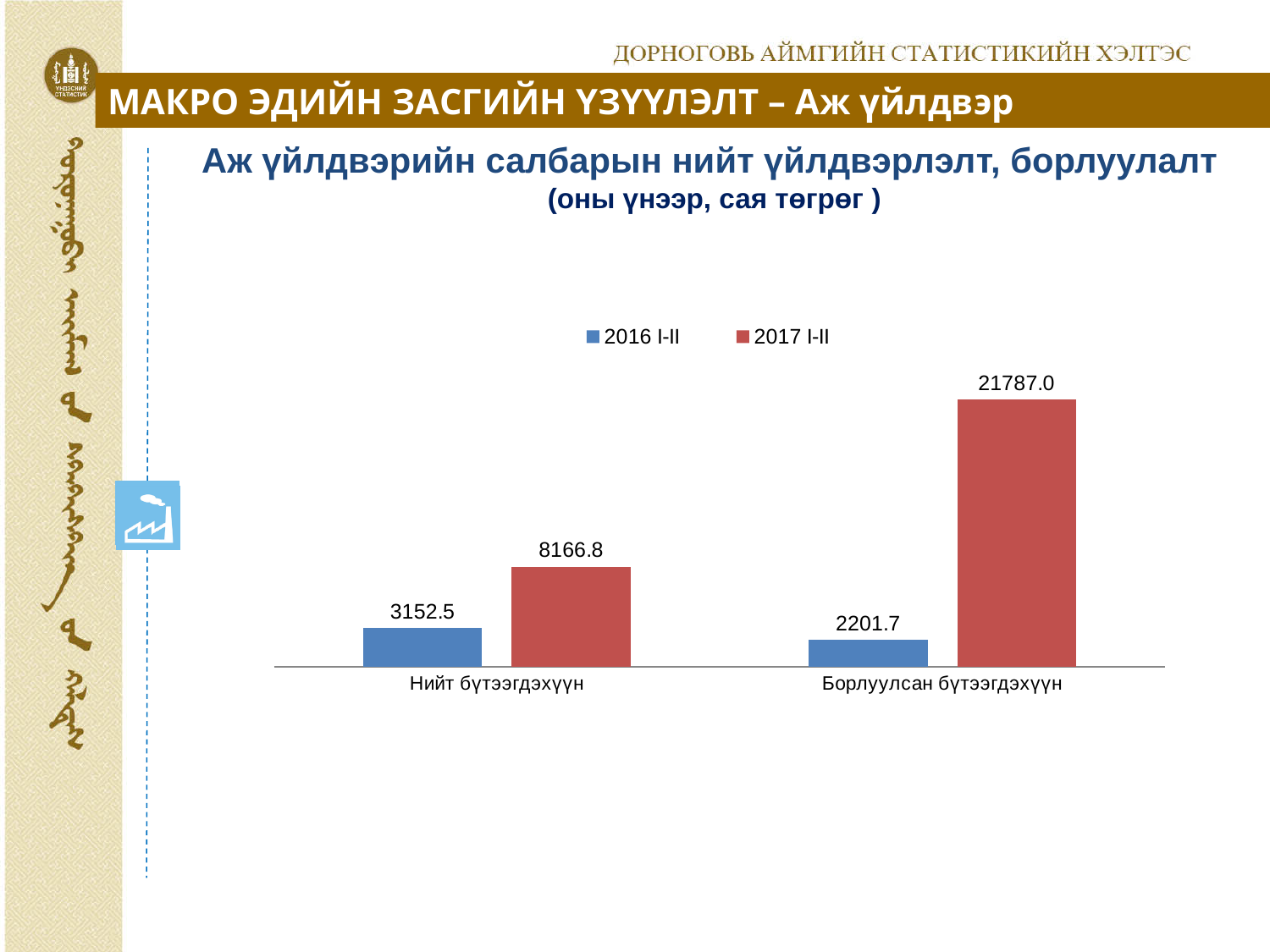
How many categories are shown on the x axis? 2 What is the value for Нийт бүтээгдэхүүн in the 2016 I-II series? 3152.5 How many series does the legend list? 2 What is the difference between the 2017 I-II and 2016 I-II values for Борлуулсан бүтээгдэхүүн? 19585.3 What kind of chart is shown on the slide? Bar chart In the 2016 I-II series, which is larger: Нийт бүтээгдэхүүн or Борлуулсан бүтээгдэхүүн? Нийт бүтээгдэхүүн Which bar has the lowest value on the chart? Борлуулсан бүтээгдэхүүн, 2016 I-II What is the value for Нийт бүтээгдэхүүн in the 2017 I-II series? 8166.8 What is the value for Борлуулсан бүтээгдэхүүн in the 2016 I-II series? 2201.7 Which bar has the highest value on the chart? Борлуулсан бүтээгдэхүүн, 2017 I-II What is the difference between the 2017 I-II and 2016 I-II values for Нийт бүтээгдэхүүн? 5014.3 What is the value for Борлуулсан бүтээгдэхүүн in the 2017 I-II series? 21787.0